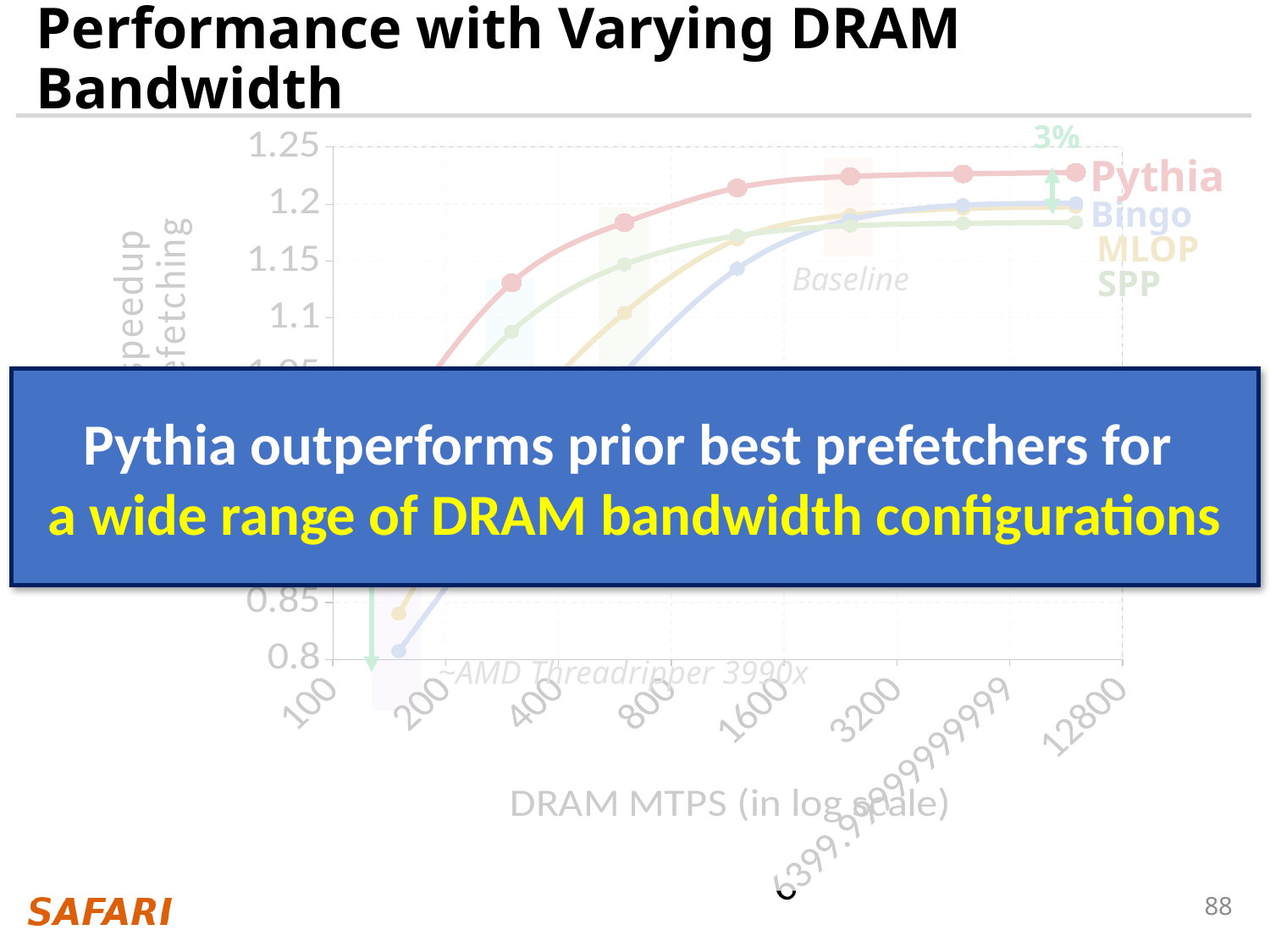
Do the speedup values for Pythia rise or fall as DRAM MTPS increases along the x axis? rise Is the value for Pythia at 800 DRAM MTPS greater or less than 1.15? greater What percentage improvement is annotated at the right end of the chart between Pythia and the next best prefetcher? 3% At 800 DRAM MTPS, which series has the larger speedup, Pythia or Bingo? Pythia How many series does the chart's legend list? 4 Which series has the lowest speedup at 12800 DRAM MTPS? SPP What is the title of the x axis of the chart? DRAM MTPS (in log scale) Is the value for Pythia at 12800 DRAM MTPS greater or less than 1.2? greater What kind of chart is shown on the slide? line chart Which series has the highest speedup at 12800 DRAM MTPS? Pythia How many tick labels are shown on the x axis of the chart? 8